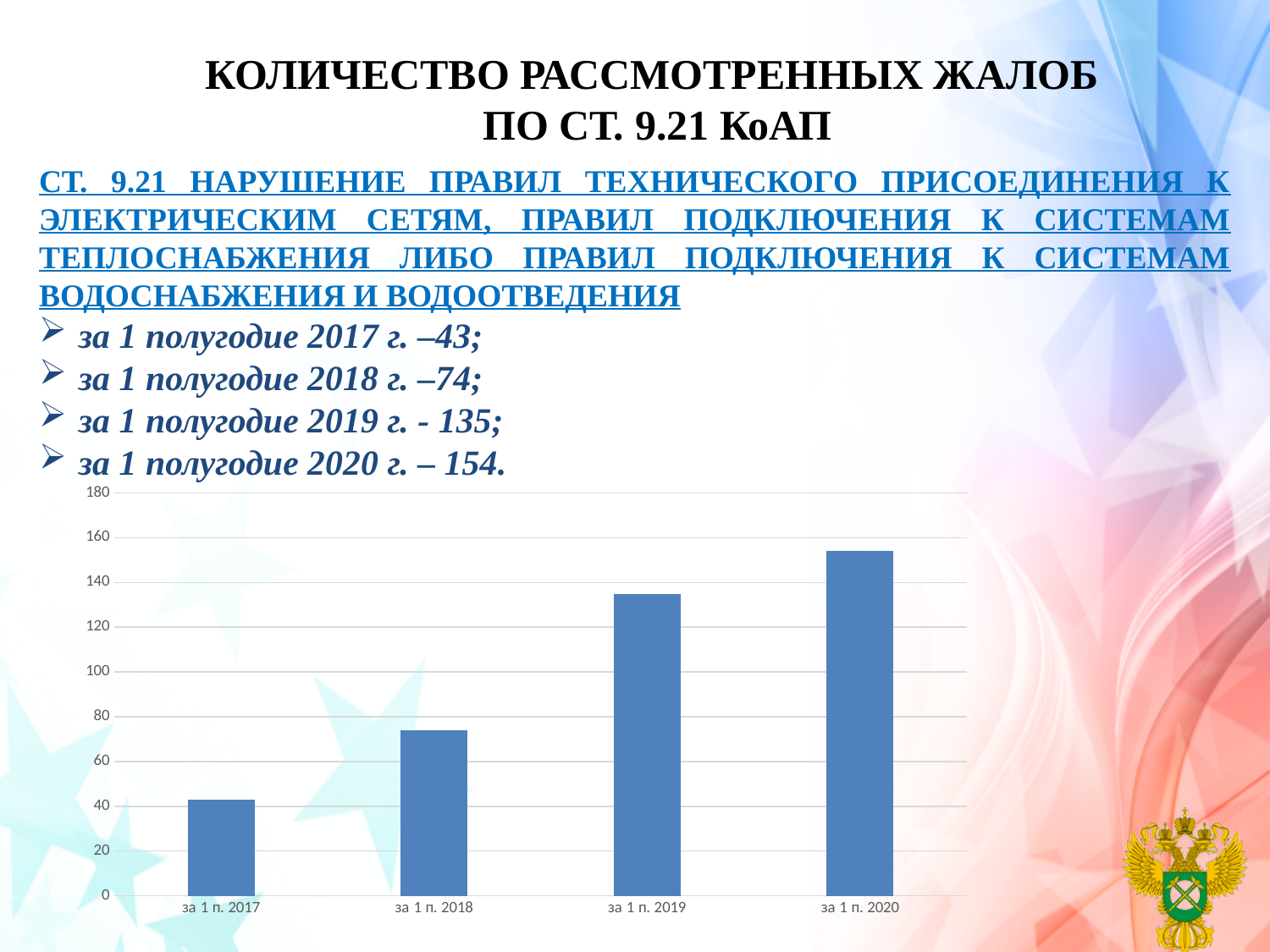
Which category has the lowest bar in the chart? за 1 п. 2017 Is the value for за 1 п. 2020 greater or less than 140? greater Do the values rise or fall from за 1 п. 2017 to за 1 п. 2020? rise Which is larger, the value for за 1 п. 2018 or за 1 п. 2019? за 1 п. 2019 How many categories (bars) does the chart show? 4 Which category has the highest bar in the chart? за 1 п. 2020 What kind of chart is shown on the slide? bar chart What colour are the bars in the chart? blue What is the number of complaints considered for за 1 п. 2017? 43 Is the value for за 1 п. 2018 greater or less than 80? less What is the number of complaints considered for за 1 п. 2019? 135 What is the difference between the values for за 1 п. 2020 and за 1 п. 2019? 19